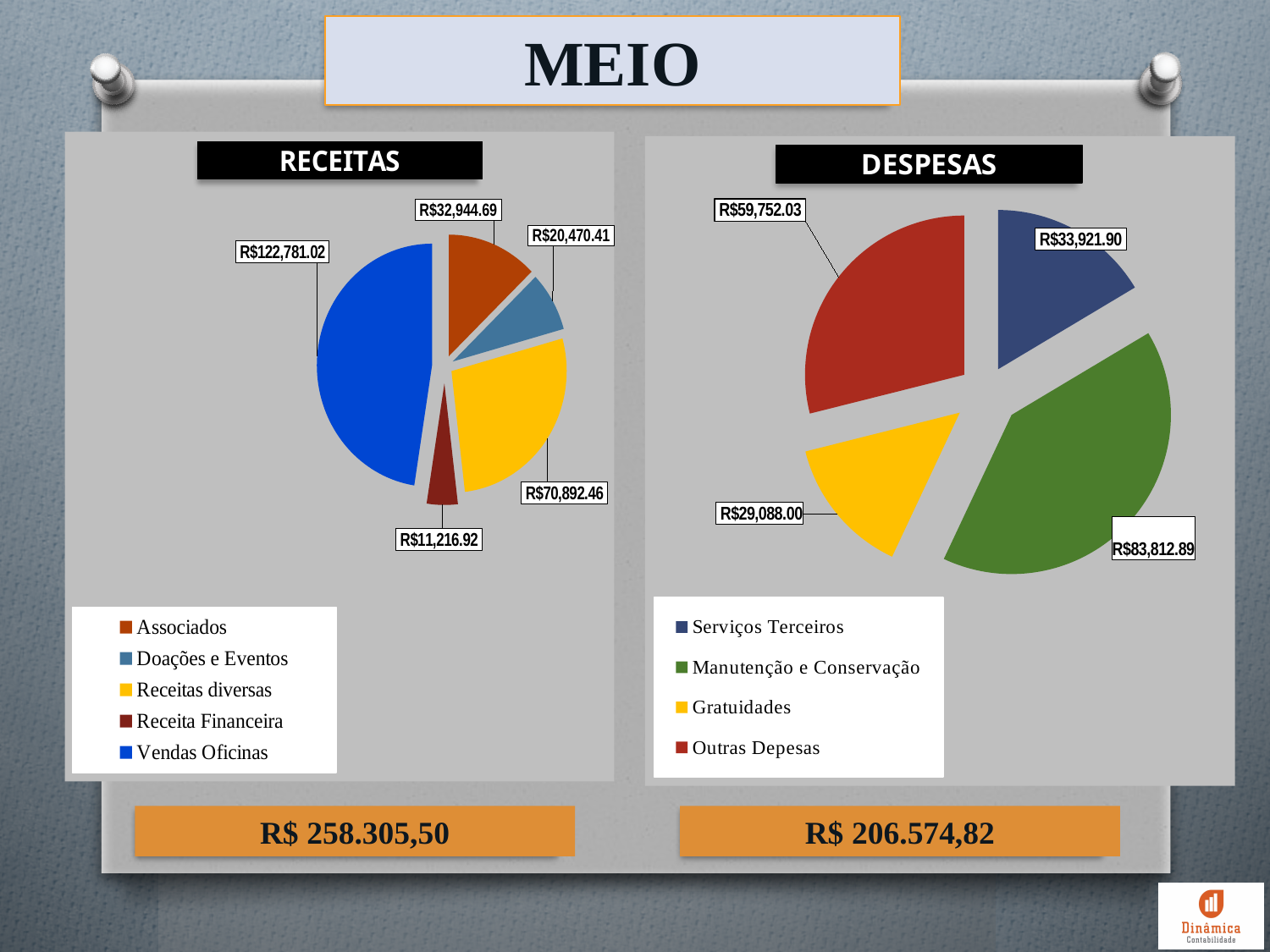
How many categories does the DESPESAS chart show? 4 In the RECEITAS chart, what is the value for Vendas Oficinas? R$122,781.02 What type of chart is the RECEITAS chart? Pie chart In the DESPESAS chart, what is the value for Gratuidades? R$29,088.00 In the DESPESAS chart, which colour represents Serviços Terceiros? Dark blue In the DESPESAS chart, what is the value for Outras Depesas? R$59,752.03 In the RECEITAS chart, which is larger: Associados or Doações e Eventos? Associados In the DESPESAS chart, what is the difference between Manutenção e Conservação and Outras Depesas? R$24,060.86 In the RECEITAS chart, what is the value for Receita Financeira? R$11,216.92 In the RECEITAS chart, what is the difference between Vendas Oficinas and Receitas diversas? R$51,888.56 In the DESPESAS chart, which category has the smallest value? Gratuidades In the RECEITAS chart, which category has the largest value? Vendas Oficinas